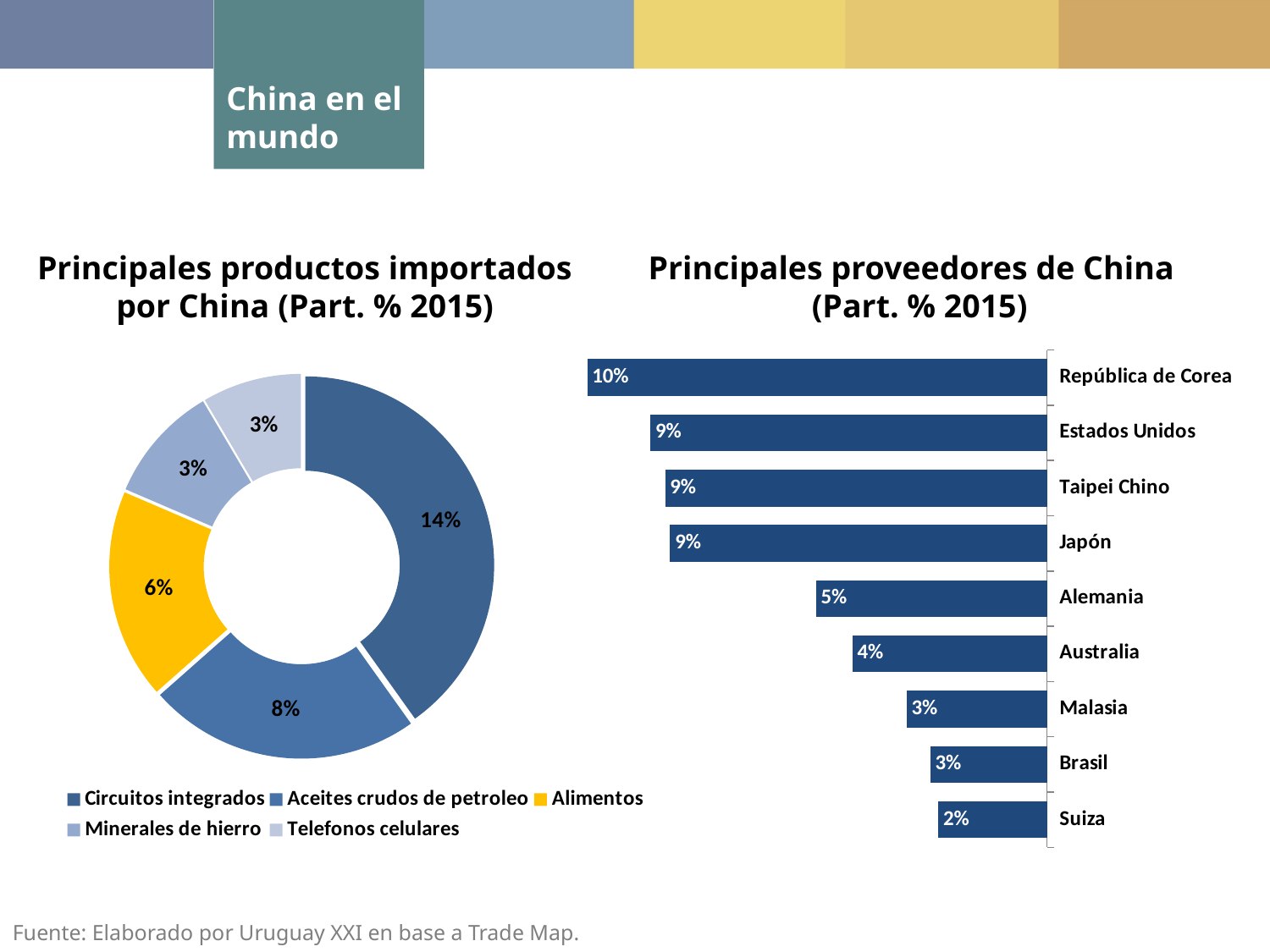
In the chart 'Principales proveedores de China (Part. % 2015)', which country has the highest value? República de Corea How many categories does the legend of the chart 'Principales productos importados por China (Part. % 2015)' list? 5 In the chart 'Principales proveedores de China (Part. % 2015)', which country has the lowest value? Suiza In the chart 'Principales productos importados por China (Part. % 2015)', what is the share for Circuitos integrados? 14% In the chart 'Principales productos importados por China (Part. % 2015)', which is larger, Aceites crudos de petroleo or Alimentos? Aceites crudos de petroleo In the chart 'Principales proveedores de China (Part. % 2015)', how many countries are shown? 9 In the chart 'Principales productos importados por China (Part. % 2015)', what is the value for Alimentos? 6% In the chart 'Principales proveedores de China (Part. % 2015)', what is the difference between the values for República de Corea and Australia? 6% In the chart 'Principales proveedores de China (Part. % 2015)', what is the value for República de Corea? 10% What kind of chart is 'Principales proveedores de China (Part. % 2015)'? Bar chart In the chart 'Principales productos importados por China (Part. % 2015)', which category is shown in yellow? Alimentos In the chart 'Principales proveedores de China (Part. % 2015)', what is the value for Alemania? 5%